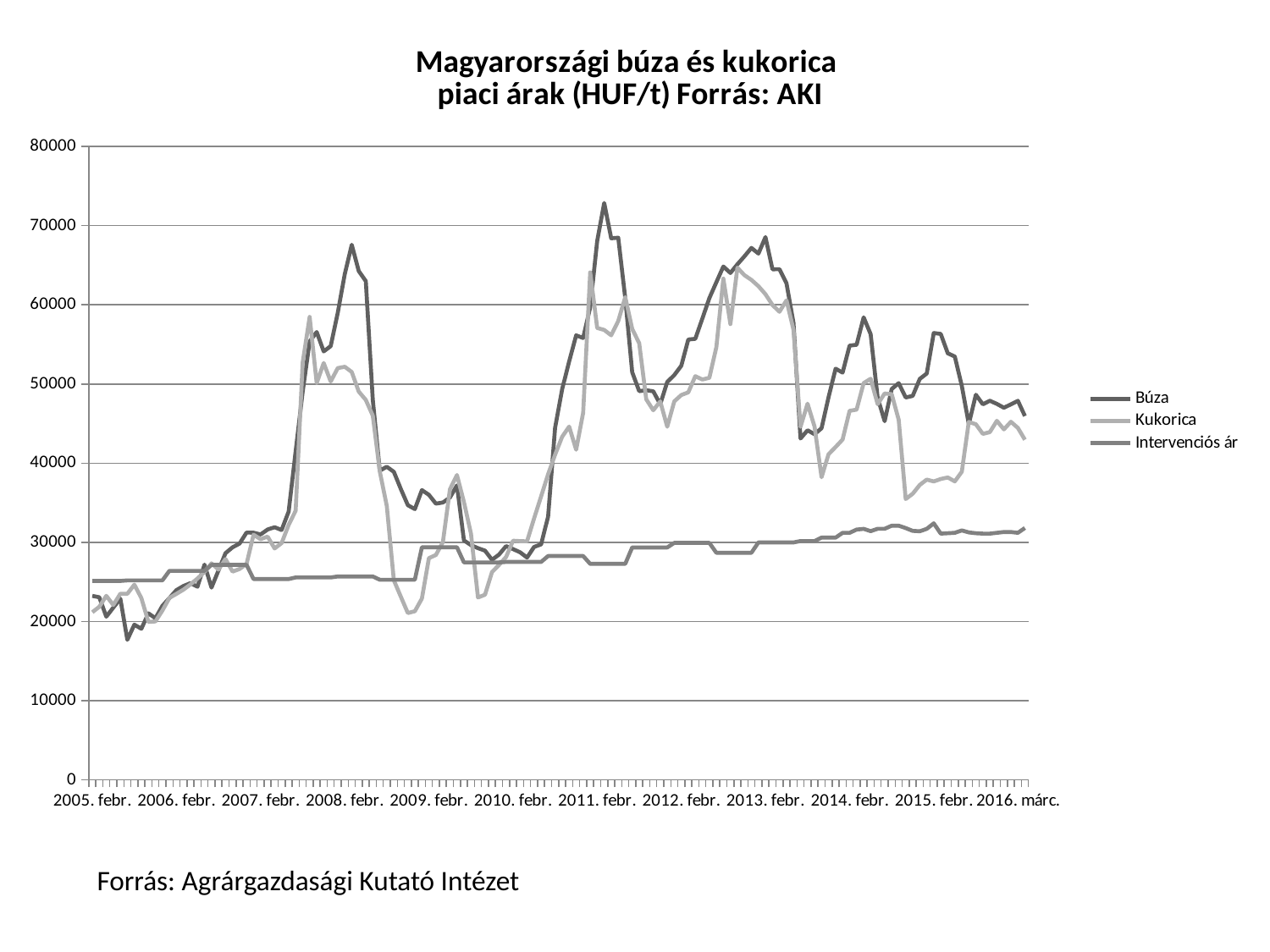
Does the Intervenciós ár series generally rise or fall from 2005. febr. to 2016. márc.? rise What unit is given in the chart title for the prices? HUF/t Which series reaches the highest value anywhere on the chart? Búza At 2008. febr., which is larger: Búza or Intervenciós ár? Búza Is the value of Búza at 2016. márc. greater or less than 40000? greater Is the value of Búza at 2005. febr. greater or less than 30000? less What are the three series named in the legend? Búza, Kukorica, Intervenciós ár Is the value of Intervenciós ár at 2005. febr. greater or less than 20000? greater What kind of chart is shown on the slide? line chart At 2016. márc., which is larger: Búza or Intervenciós ár? Búza How many series does the legend list? 3